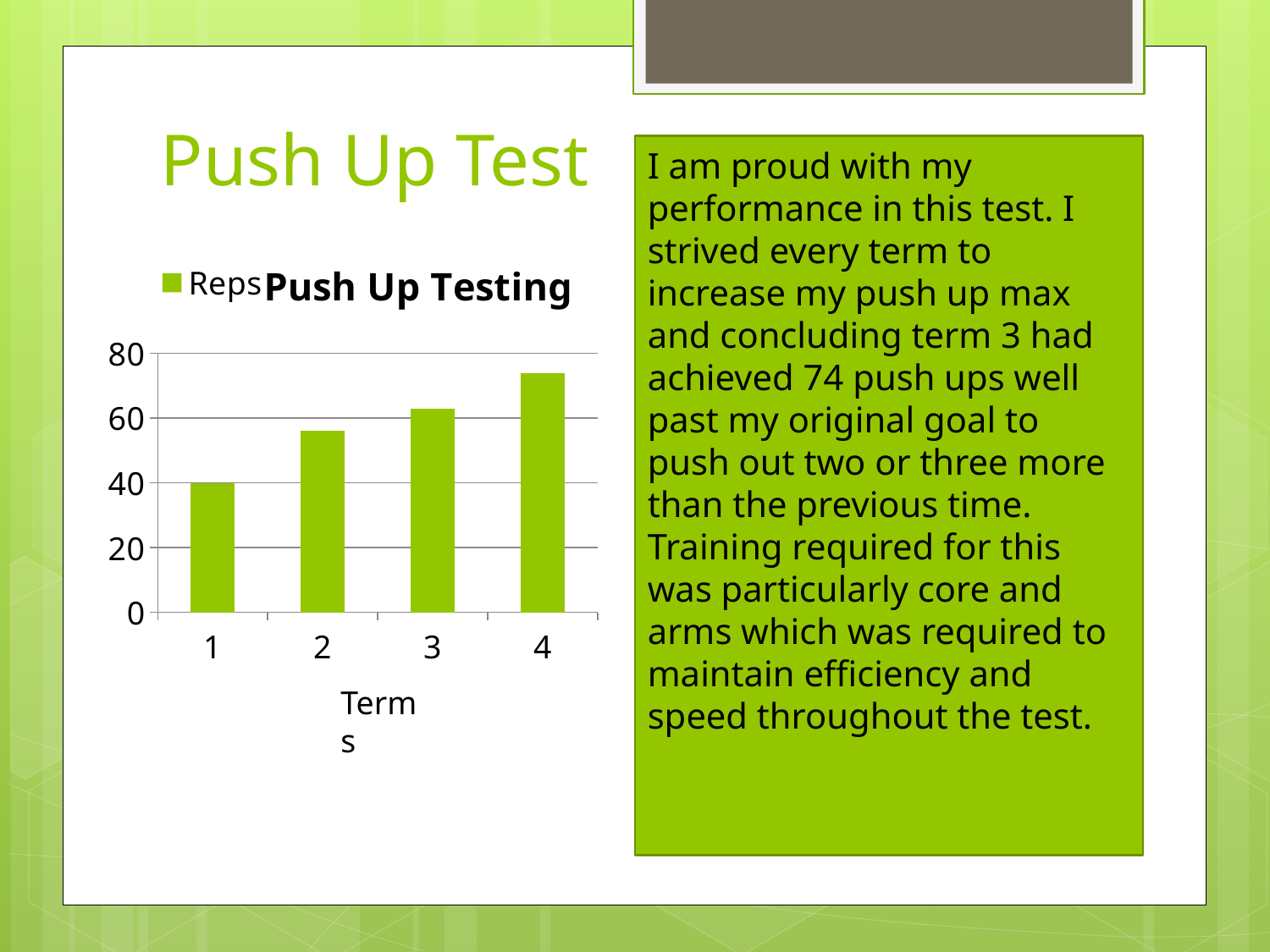
What is the name of the series shown in the legend? Reps Is the value for term 2 greater or less than 60? less Is the value for term 4 greater or less than 80? less What is the value for term 1? 40 Do the values rise or fall from term 1 to term 4? rise Which term has the lowest value? 1 What is the title of the chart? Push Up Testing How many series does the legend list? 1 Which term has the highest value? 4 Is the value for term 3 greater or less than 60? greater How many terms are plotted on the x axis? 4 What type of chart is shown on the slide? bar chart